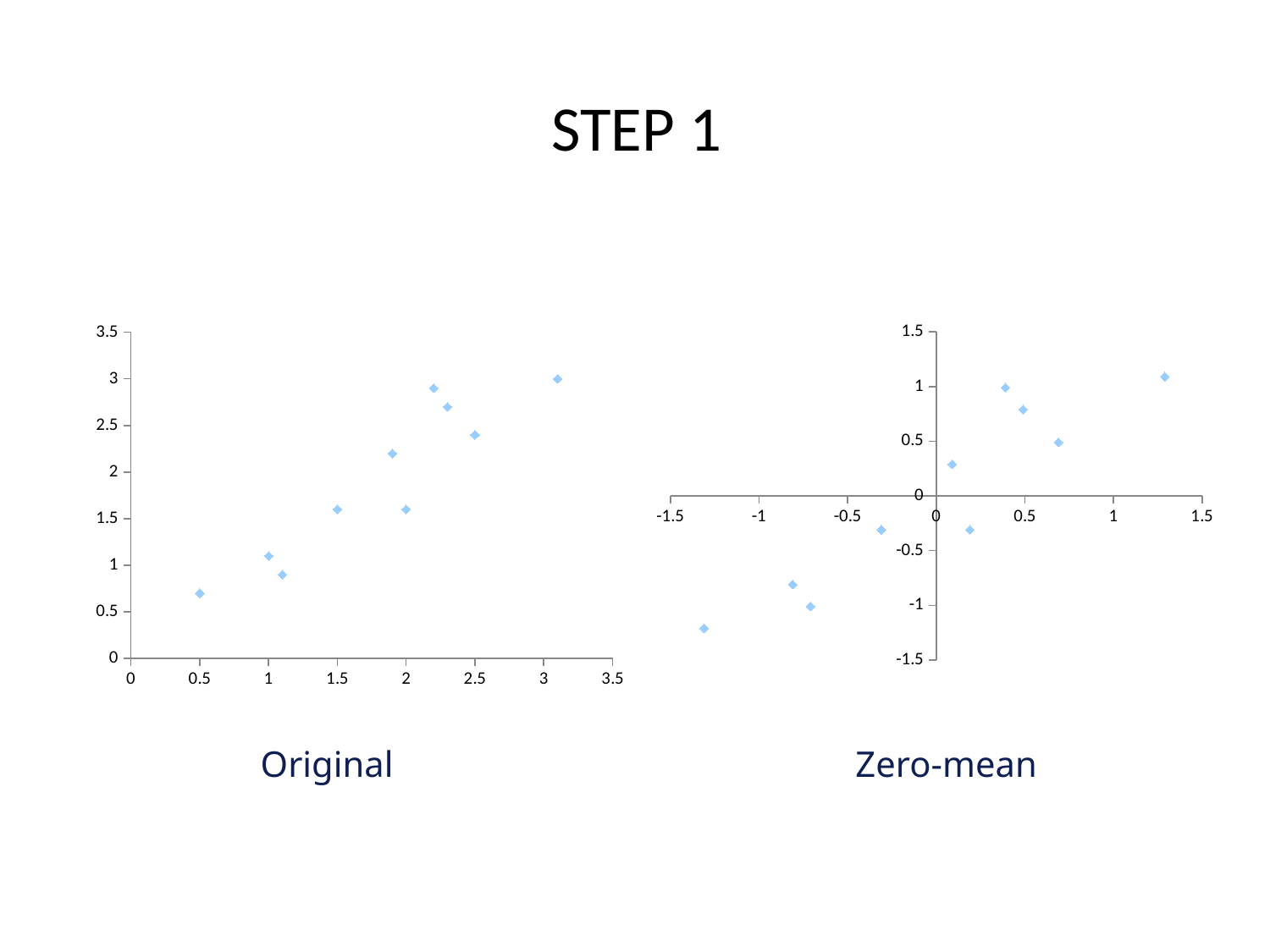
How many data points are plotted in the Original chart? 10 What is the maximum value shown on the x axis of the Original chart? 3.5 In the Zero-mean chart, is the y value of the lowest point greater or less than -1? less What kind of chart is the Original chart on the left? Scatter chart What kind of chart is the Zero-mean chart on the right? Scatter chart What are the labels given beneath the two charts on the slide? Original and Zero-mean In the Original chart, is the y value of the leftmost point greater or less than 1? less In the Zero-mean chart, is the y value of the rightmost point greater or less than 1? greater In the Original chart, do the y values generally rise or fall as x increases? Rise How many data points are plotted in the Zero-mean chart? 10 In the Zero-mean chart, do the y values generally rise or fall as x increases? Rise